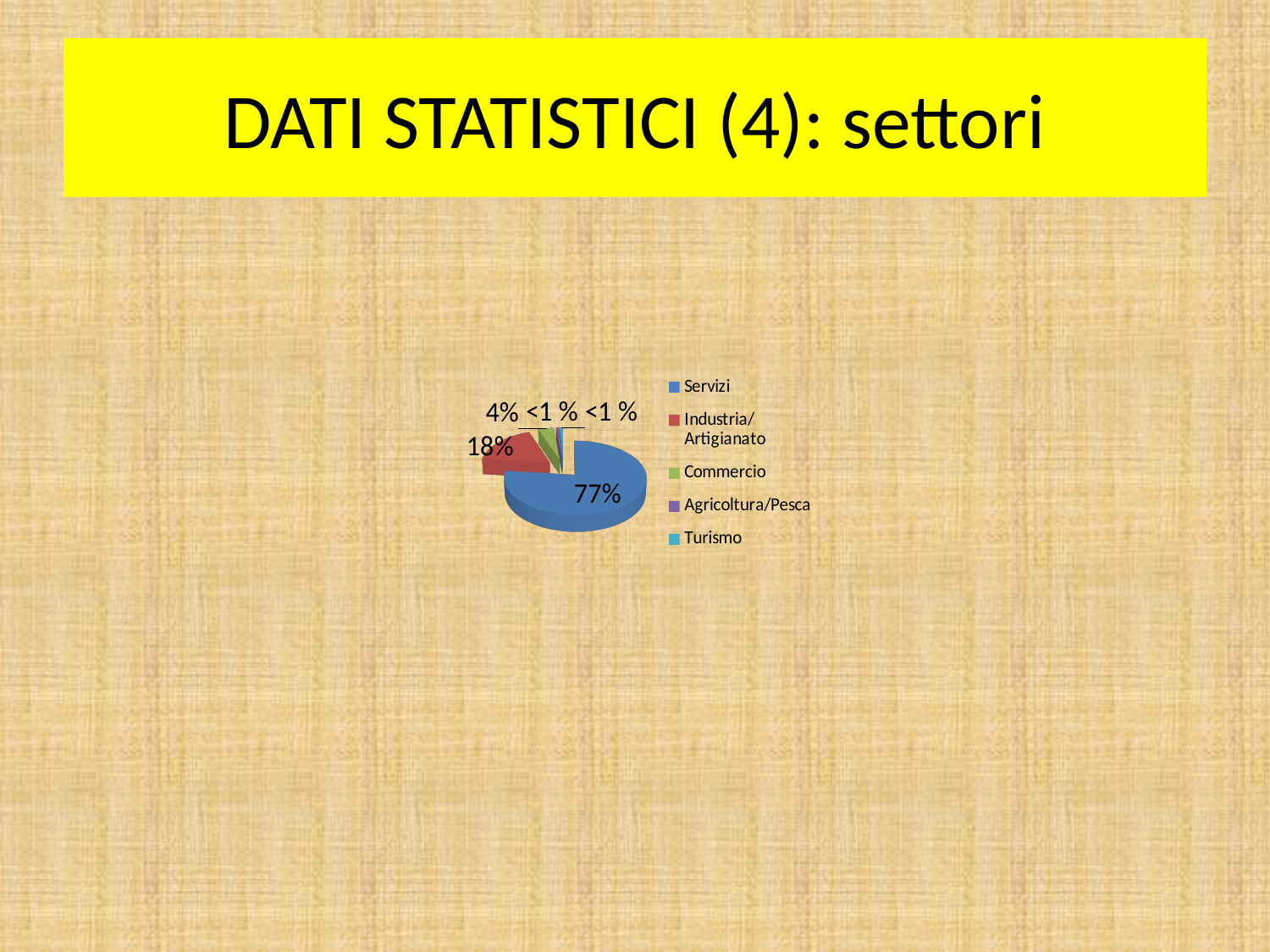
What share of the pie does Servizi account for? 77% What is the difference in percentage points between Servizi and Industria/Artigianato? 59 What is the value shown for Turismo? <1 % Which sector has the largest slice of the pie? Servizi Which is larger, the slice for Industria/Artigianato or the slice for Commercio? Industria/Artigianato What kind of chart is shown on the slide? Pie chart What is the value shown for Commercio? 4% What is the difference in percentage points between Industria/Artigianato and Commercio? 14 How many sectors does the legend of the pie chart list? 5 What is the value shown for Industria/Artigianato? 18% What is the value shown for Agricoltura/Pesca? <1 % What colour is the Servizi slice in the pie chart? Blue